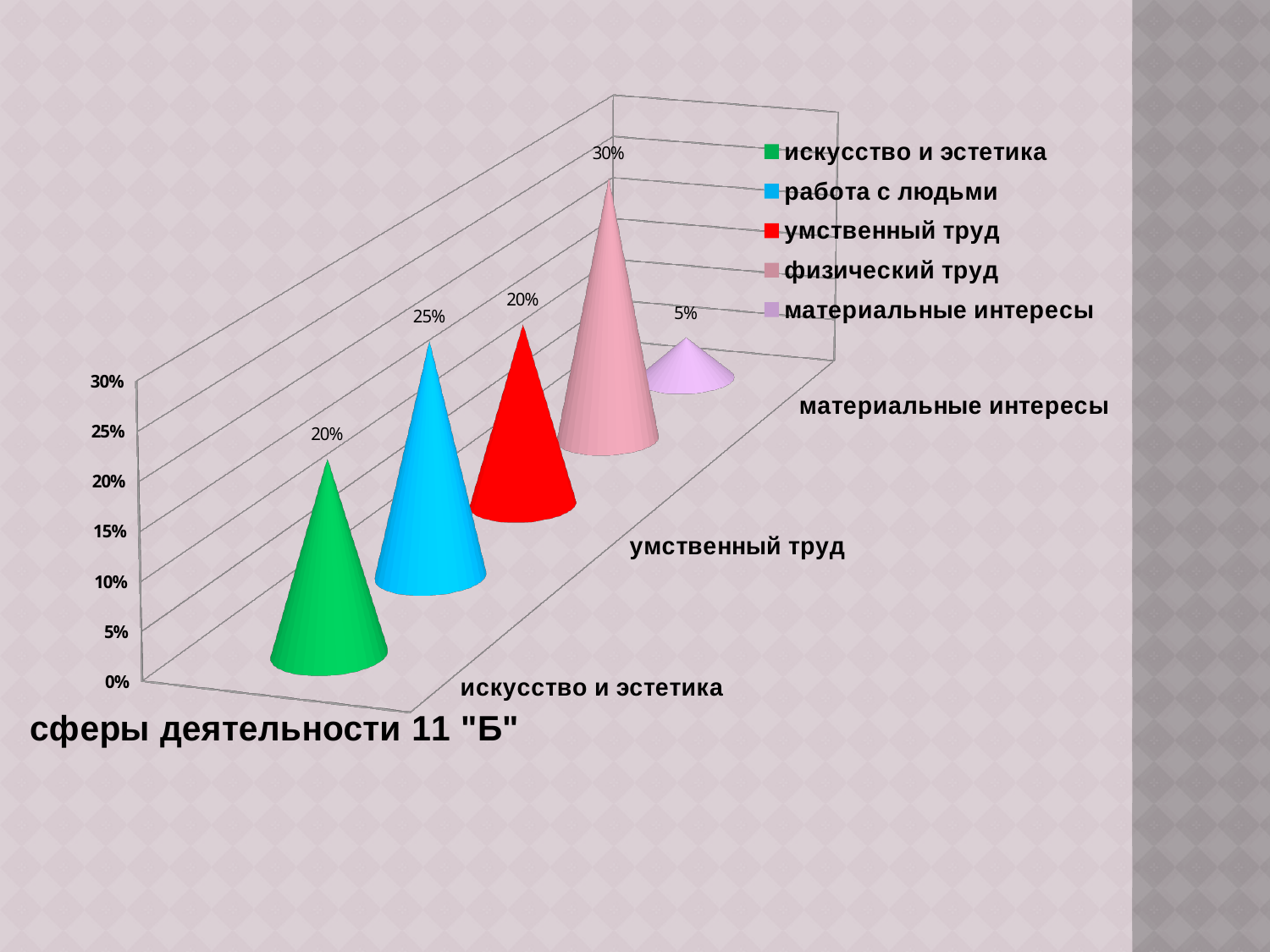
How many categories are plotted in the chart? 5 What is the value for физический труд? 30% What is the value for работа с людьми? 25% Which category has the highest value? физический труд Which category has the lowest value? материальные интересы What is the value for материальные интересы? 5% How many entries does the legend list? 5 What is the difference between the values for физический труд and материальные интересы? 25% What is the title of the chart? сферы деятельности 11 "Б" What is the value for искусство и эстетика? 20% What kind of chart is shown on the slide? 3D bar chart Which is larger, the value for работа с людьми or the value for умственный труд? работа с людьми